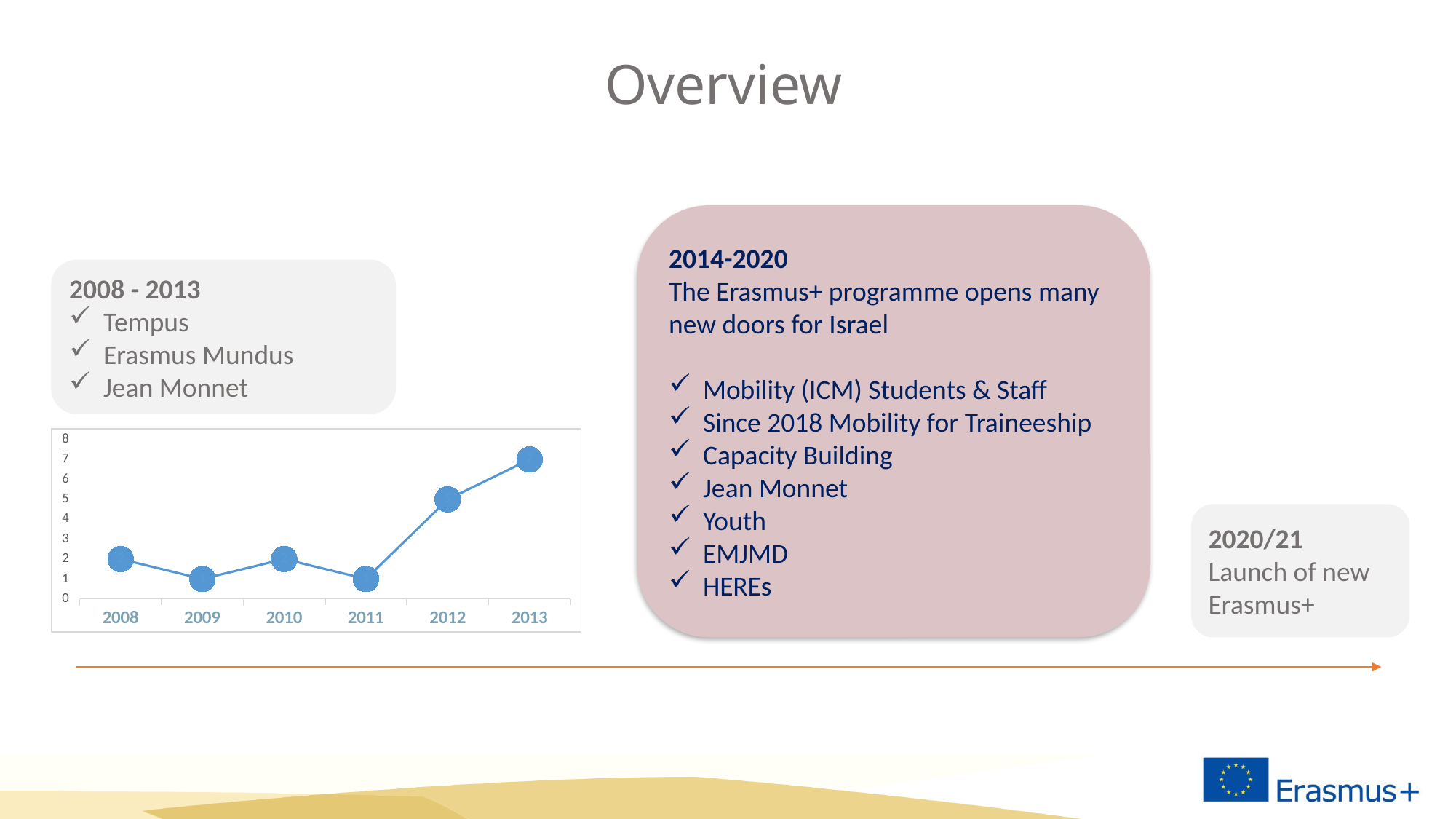
Which year has the highest value in the chart? 2013 Do the values rise or fall from 2011 to 2013? rise Which is larger, the value for 2012 or the value for 2010? 2012 Is the value for 2008 greater or less than 4? less Is the value for 2009 greater or less than 2? less Which is larger, the value for 2008 or the value for 2009? 2008 Is the value for 2011 greater or less than 3? less What kind of chart is shown on the slide? line chart How many years are plotted on the x axis of the chart? 6 What is the first year shown on the x axis of the chart? 2008